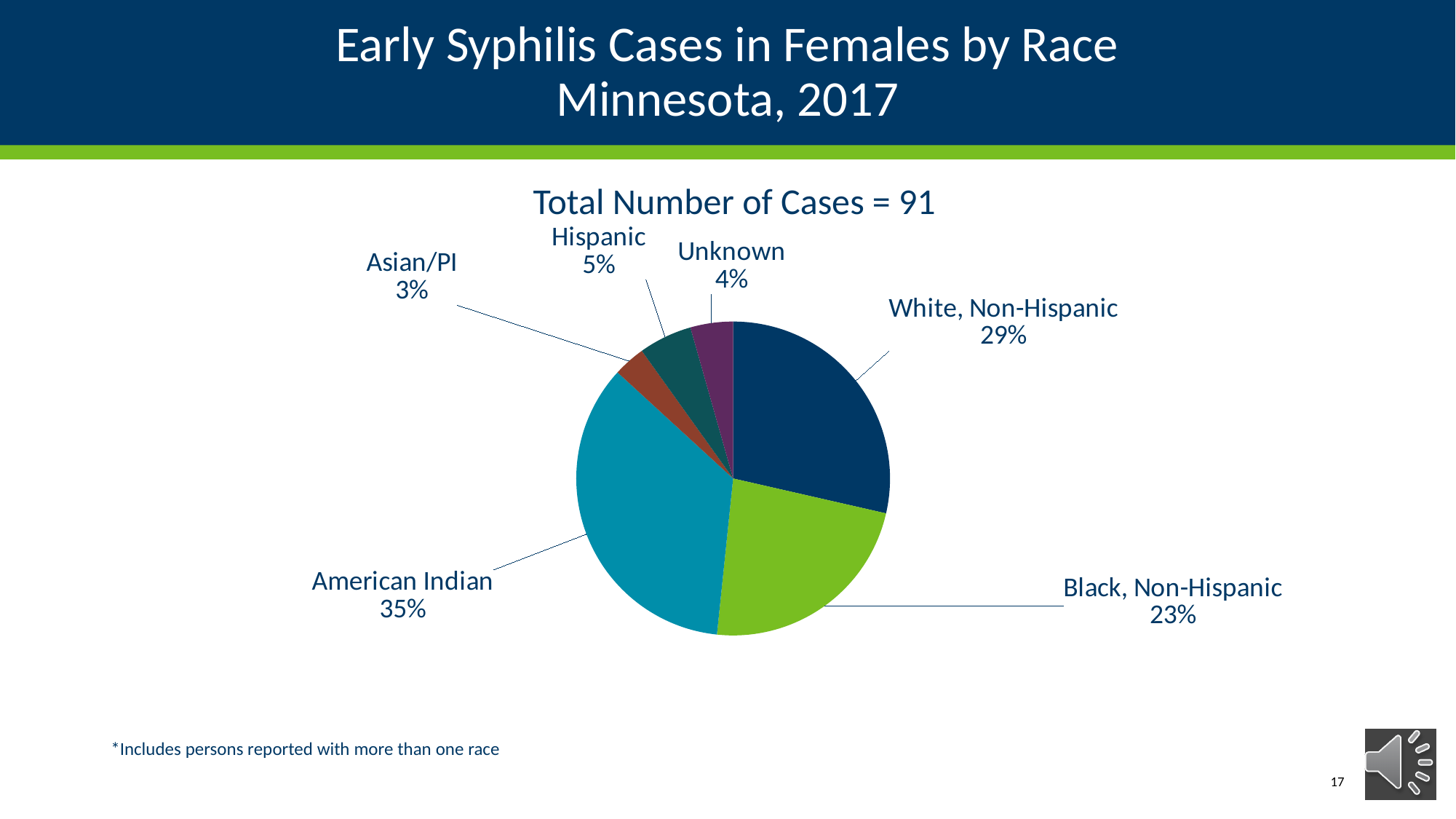
What share of cases is Asian/PI? 3% How many race categories are shown in the pie chart? 6 What share of cases is White, Non-Hispanic? 29% What share of early syphilis cases in females is American Indian? 35% What is the difference in percentage points between the American Indian and White, Non-Hispanic shares? 6 Which race category has the largest share of cases? American Indian Which is larger, the Black, Non-Hispanic share or the White, Non-Hispanic share? White, Non-Hispanic What is the total number of cases stated on the chart? 91 What kind of chart is shown on the slide? pie chart Which race category has the smallest share of cases? Asian/PI